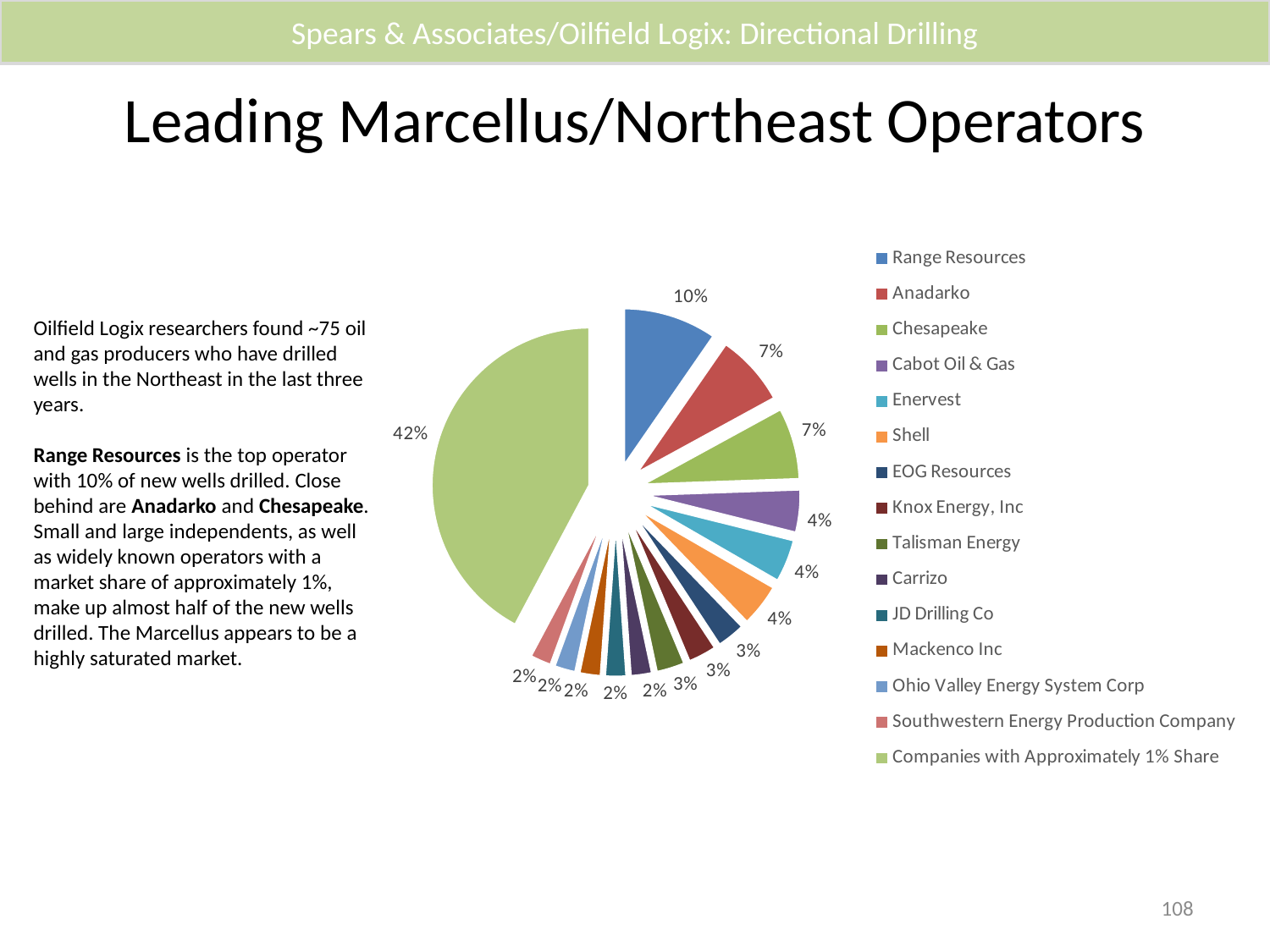
What is the title of the chart on the slide? Leading Marcellus/Northeast Operators What share of the pie does Cabot Oil & Gas have? 4% What share of the pie does Chesapeake have? 7% What share of the pie does Range Resources have? 10% Which category has the largest share of the pie? Companies with Approximately 1% Share What kind of chart is shown on the slide? pie chart What is the difference between the share for Range Resources and the share for Anadarko? 3% How many slices does the pie chart have? 15 Which is larger, the share for Range Resources or the share for Shell? Range Resources